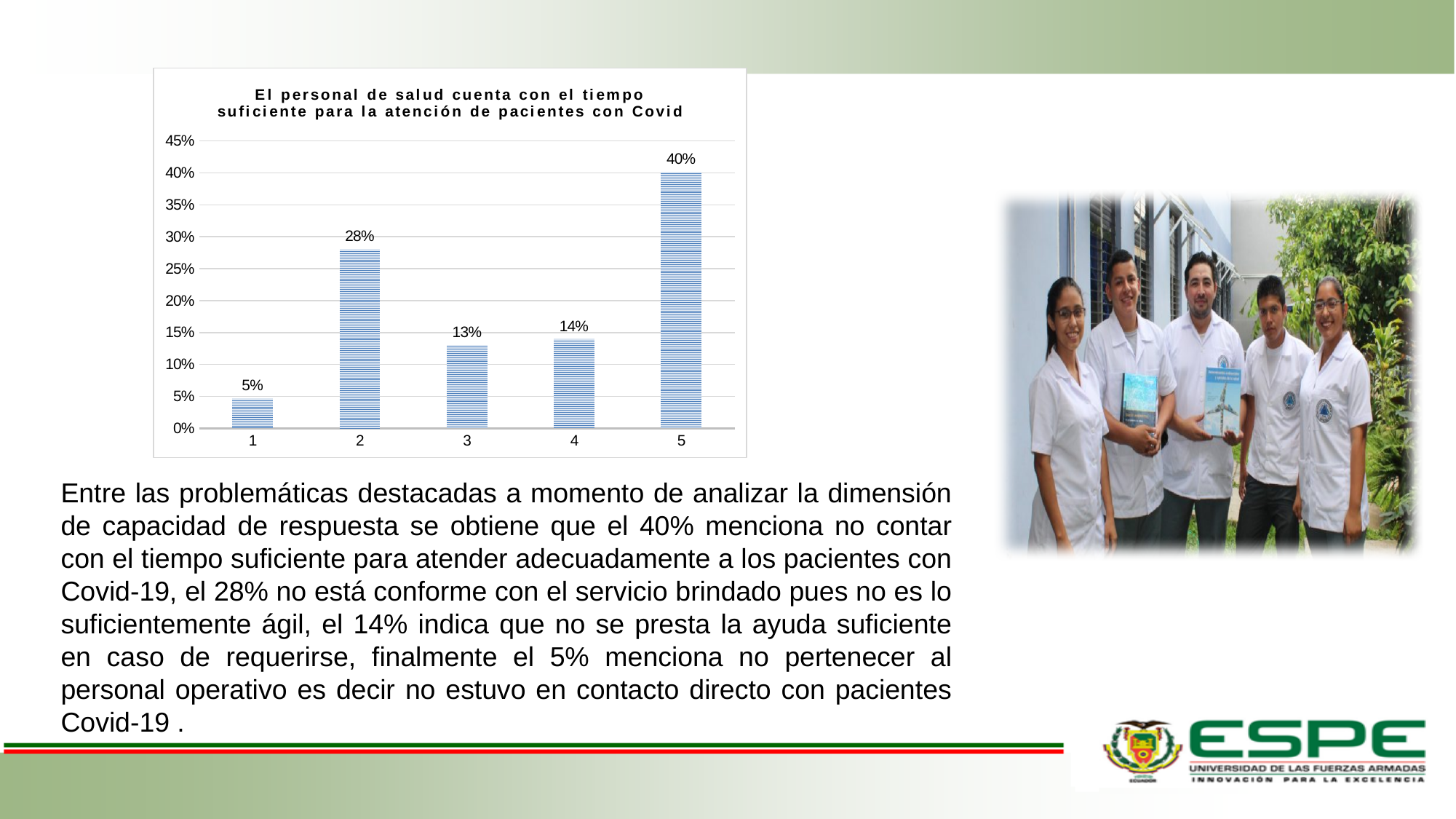
What is the title of the chart? El personal de salud cuenta con el tiempo suficiente para la atención de pacientes con Covid What is the value for category 5? 40% What is the difference between the values for category 5 and category 2? 12% What kind of chart is shown on the slide? bar chart Which is larger, the value for category 3 or category 4? 4 What is the value for category 2? 28% What is the value for category 3? 13% Which category has the lowest value? 1 Which category has the highest value? 5 How many categories are shown on the x axis? 5 What is the value for category 1? 5% Is the value for category 2 greater or less than 25%? greater